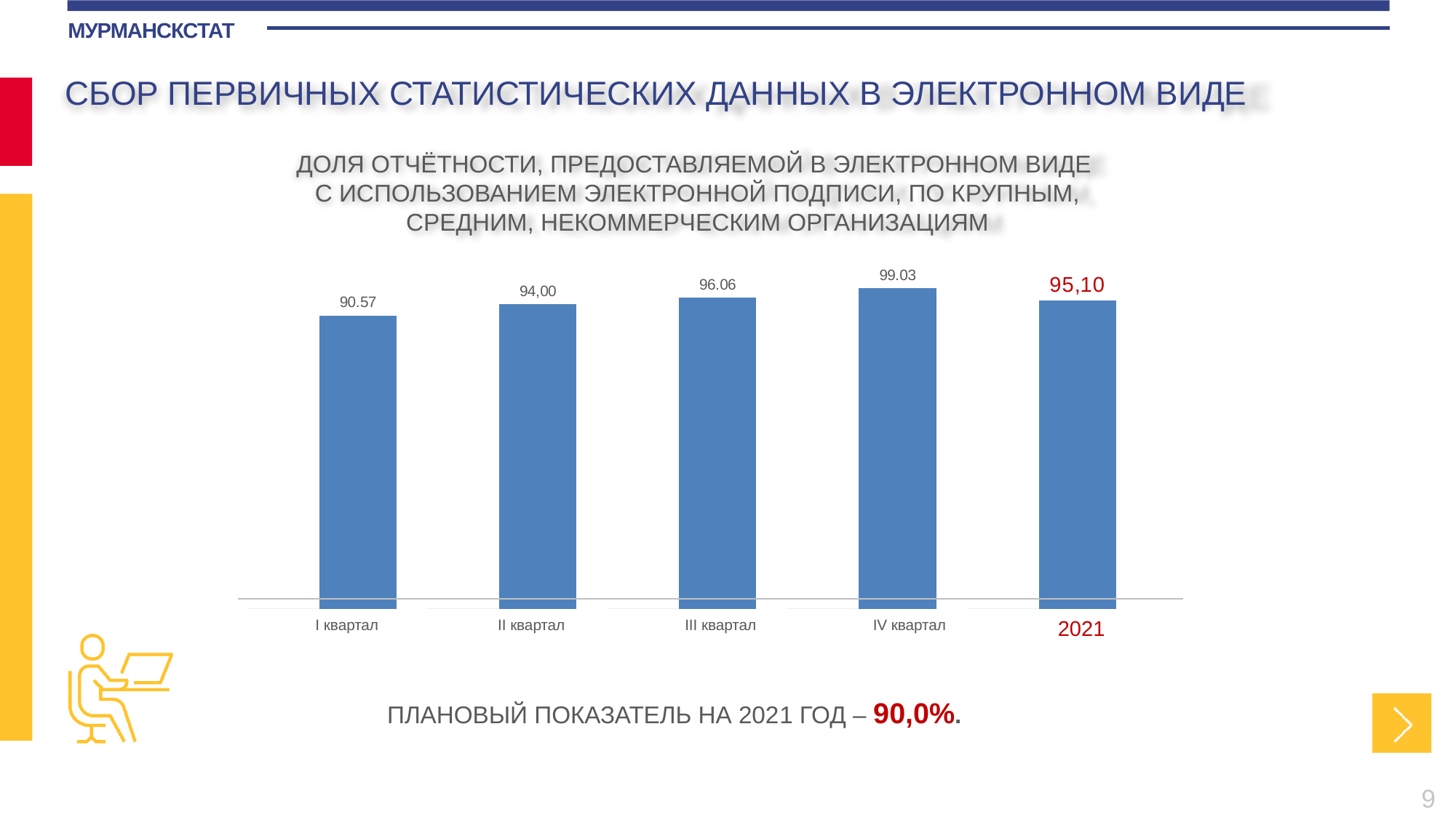
Which is larger, the value for 2021 or the value for II квартал? 2021 What is the value for 2021? 95,10 Do the values rise or fall from I квартал to IV квартал? rise How many bars are plotted in the chart? 5 Which category has the lowest value? I квартал What is the difference between the values for IV квартал and I квартал? 8.46 What is the value for I квартал? 90.57 What is the value for III квартал? 96.06 What is the value for II квартал? 94,00 Which category has the highest value? IV квартал What is the value for IV квартал? 99.03 What type of chart is shown on the slide? bar chart